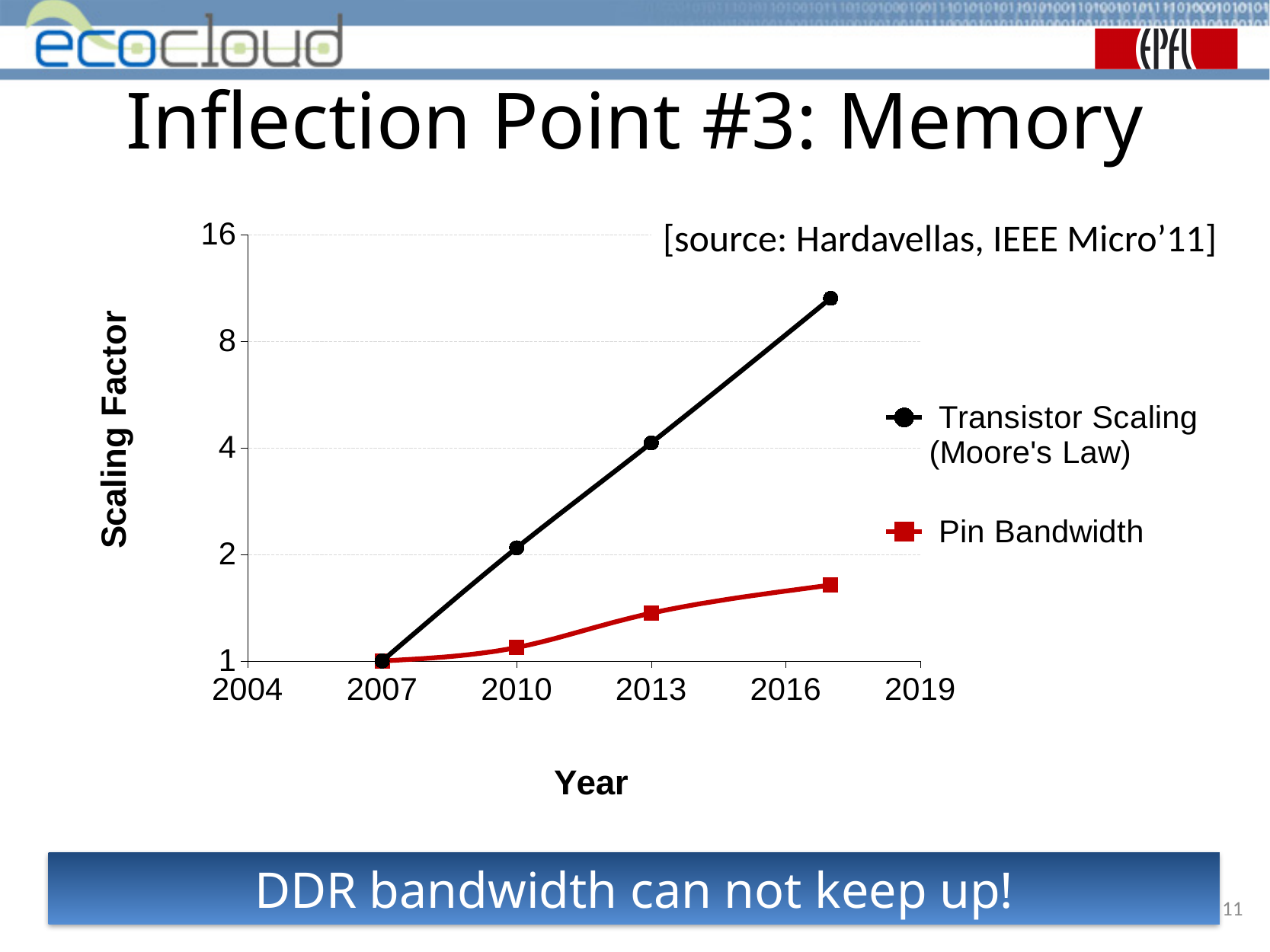
How many series does the legend list? 2 How many data points are plotted for the Transistor Scaling (Moore's Law) series? 4 Is the Transistor Scaling (Moore's Law) value in 2013 greater or less than 2? greater Is the Transistor Scaling (Moore's Law) value at the last plotted point (around 2017) greater or less than 8? greater What is the Scaling Factor value for Transistor Scaling (Moore's Law) in 2007? 1 What is the Scaling Factor value for Pin Bandwidth in 2007? 1 What kind of chart is shown on the slide? line chart Is the Pin Bandwidth value at the last plotted point (around 2017) greater or less than 2? less Which series has the higher value at the last plotted point, Transistor Scaling (Moore's Law) or Pin Bandwidth? Transistor Scaling (Moore's Law) What are the two series named in the legend? Transistor Scaling (Moore's Law) and Pin Bandwidth What is the label of the y axis? Scaling Factor Does the Pin Bandwidth series rise or fall from 2007 to the last plotted point? rise